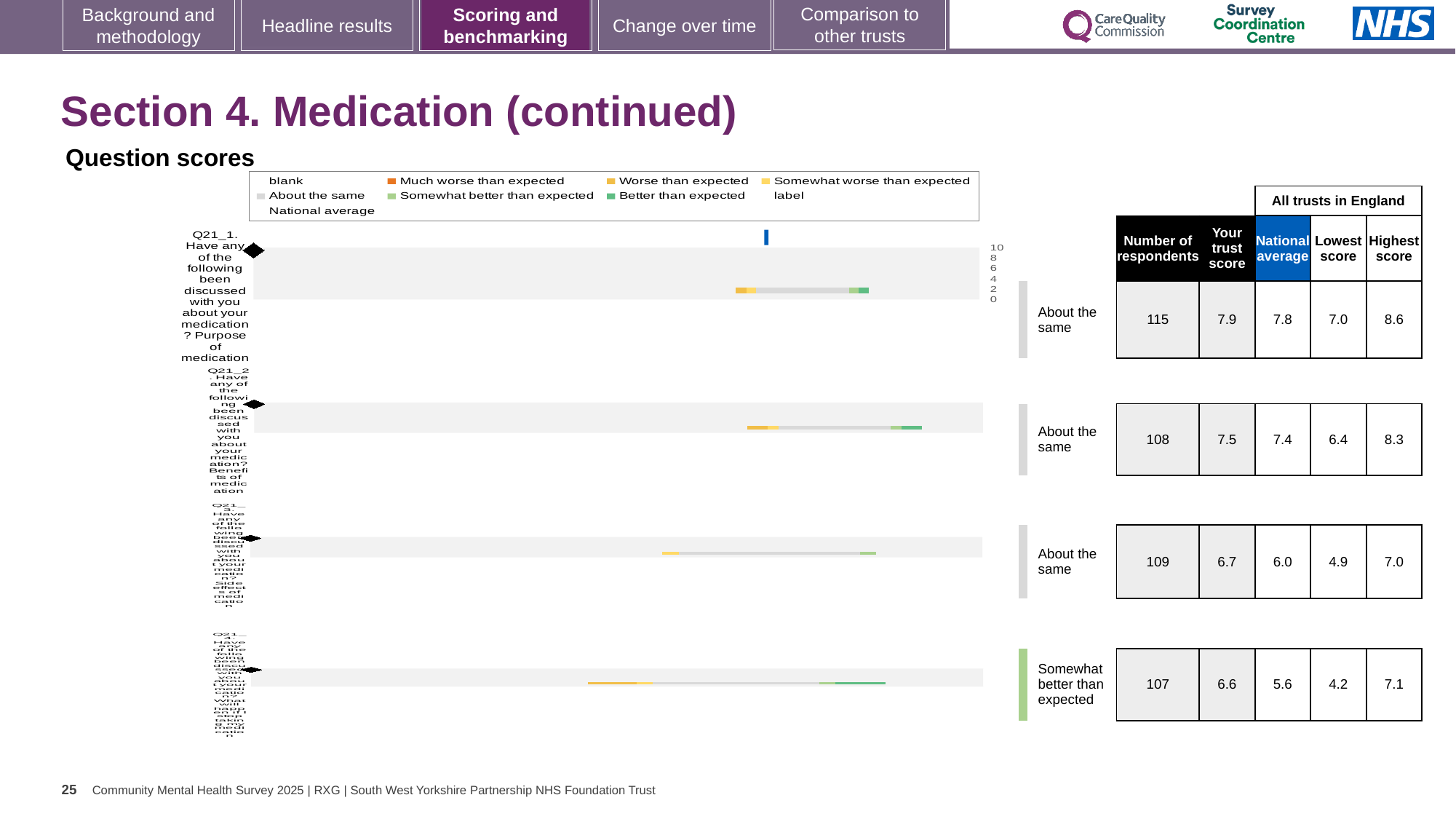
Which question has the lowest 'Your trust score'? Q21_4 What is the difference between 'Your trust score' and 'National average' for Q21_4? 1.0 What is the 'Your trust score' for Q21_1 (Purpose of medication)? 7.9 Which legend entry in the 'Question scores' chart is shown in orange? Much worse than expected What is the 'Number of respondents' for Q21_3 (Side effects of medication)? 109 Is 'Your trust score' for Q21_3 larger or smaller than its 'National average'? larger How many entries does the legend of the 'Question scores' chart list? 9 What kind of chart is shown under 'Question scores'? bar chart What is the 'National average' for Q21_2 (Benefits of medication)? 7.4 How many question bars (categories) are plotted in the 'Question scores' chart? 4 What is the highest tick value shown on the axis of the 'Question scores' chart? 10 What is the 'Highest score' for Q21_4? 7.1